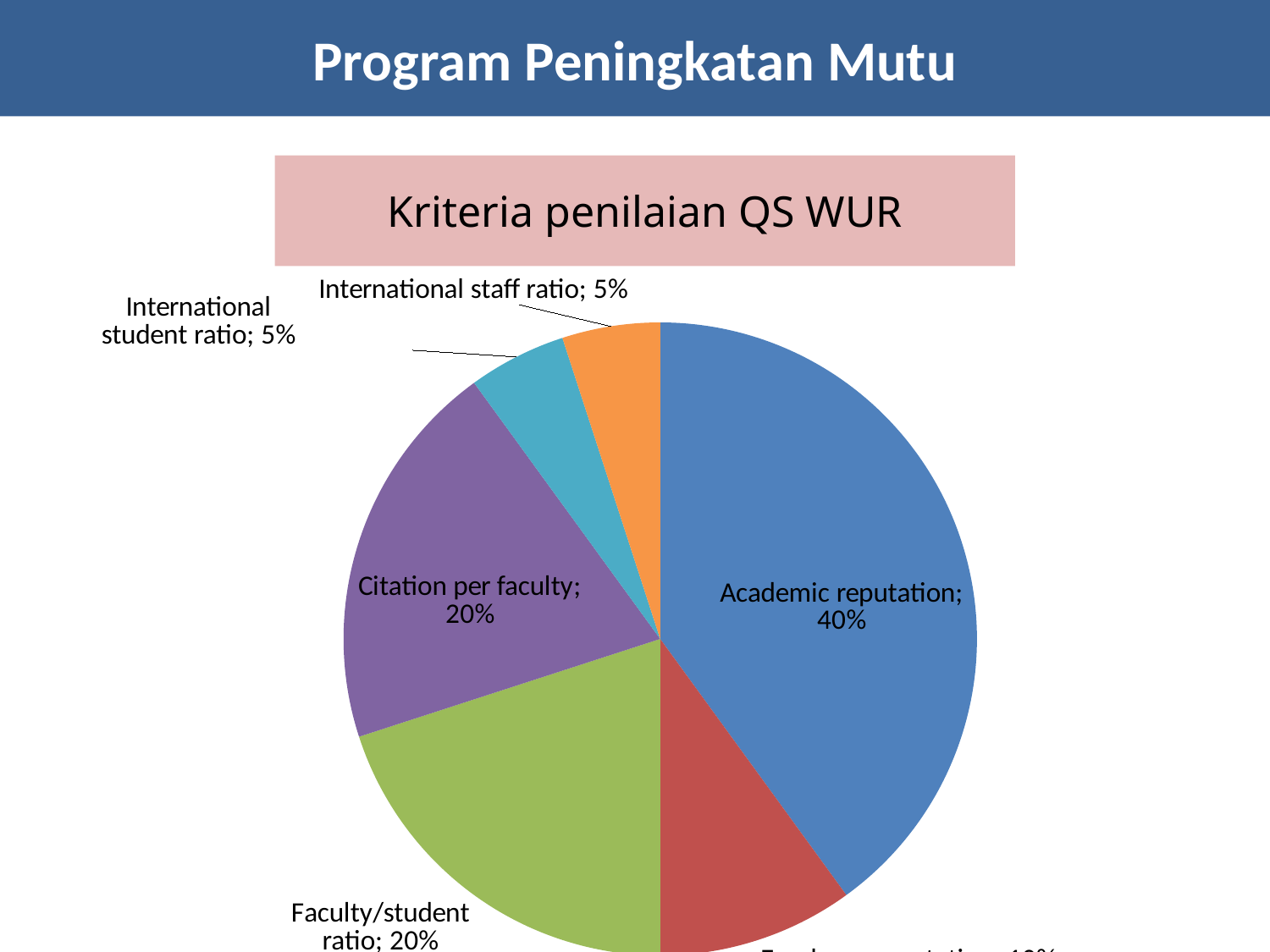
How many slices does the pie chart have? 6 What is the value for International student ratio? 5% What kind of chart is shown on the slide? pie chart What is the value for International staff ratio? 5% Which is larger, the slice for Academic reputation or the slice for Faculty/student ratio? Academic reputation What is the title shown above the pie chart? Kriteria penilaian QS WUR What share of the pie does Academic reputation have? 40% What is the difference between the Academic reputation share and the Citation per faculty share? 20% What is the value for Citation per faculty? 20% What colour is the Academic reputation slice? blue What is the value for Faculty/student ratio? 20% Which category has the largest slice of the pie? Academic reputation